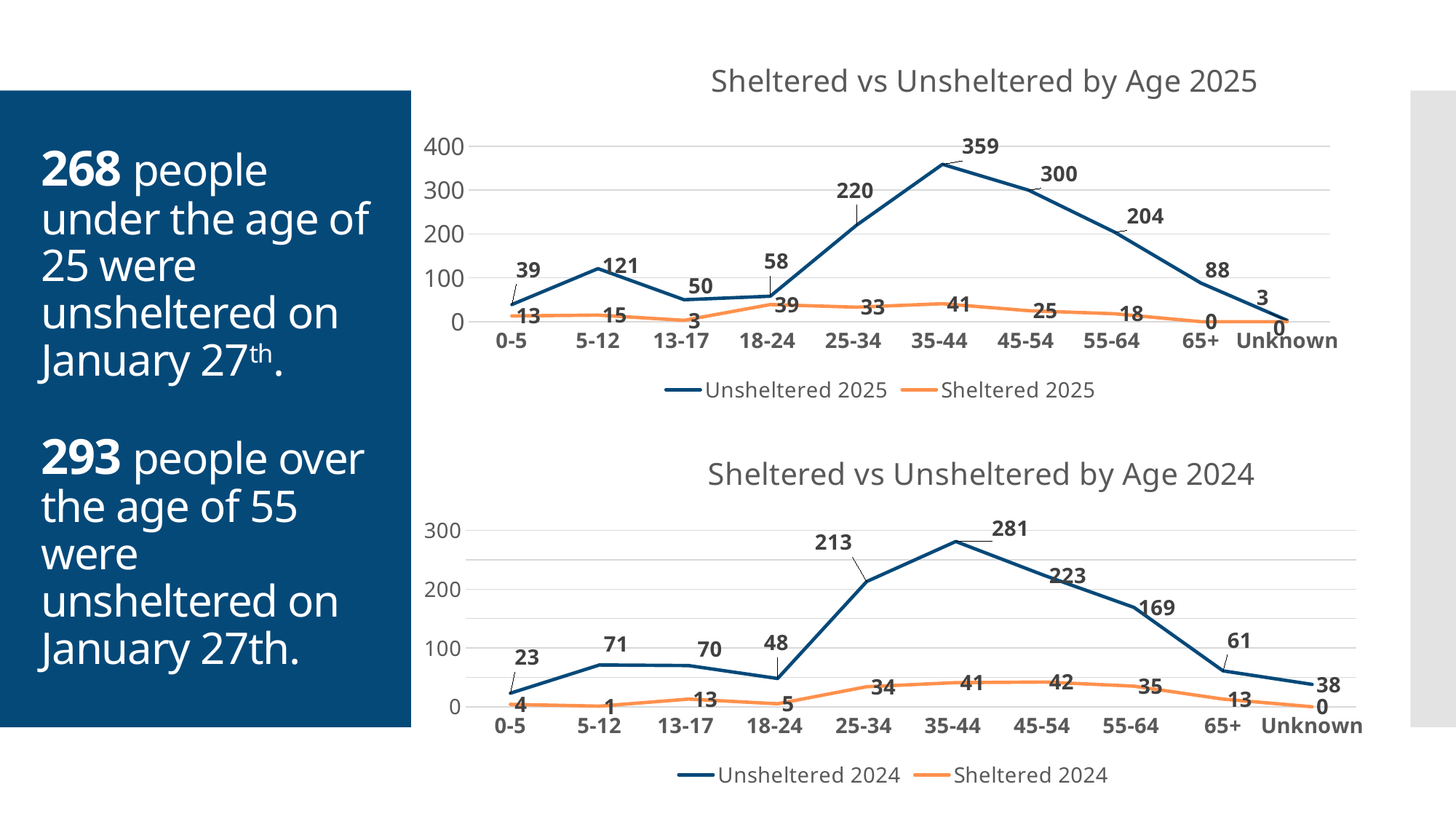
In the 'Sheltered vs Unsheltered by Age 2025' chart, is the Unsheltered 2025 value for 55-64 greater or less than 200? greater In the 'Sheltered vs Unsheltered by Age 2024' chart, which is larger: the Unsheltered 2024 value for 25-34 or for 55-64? 25-34 How many age categories are shown on the x axis of the 'Sheltered vs Unsheltered by Age 2024' chart? 10 In the 'Sheltered vs Unsheltered by Age 2025' chart, does the Unsheltered 2025 line rise or fall from 35-44 to Unknown? Fall In the 'Sheltered vs Unsheltered by Age 2024' chart, what is the Unsheltered 2024 value for the Unknown category? 38 In the 'Sheltered vs Unsheltered by Age 2024' chart, which age group has the highest Unsheltered 2024 value? 35-44 What type of chart is 'Sheltered vs Unsheltered by Age 2024'? Line chart In the 'Sheltered vs Unsheltered by Age 2025' chart, what is the difference between the Unsheltered 2025 and Sheltered 2025 values for the 45-54 age group? 275 In the 'Sheltered vs Unsheltered by Age 2025' chart, what is the Unsheltered 2025 value for the 35-44 age group? 359 In the 'Sheltered vs Unsheltered by Age 2024' chart, which age group has the lowest Sheltered 2024 value? Unknown How many series does the legend of the 'Sheltered vs Unsheltered by Age 2025' chart list? 2 In the 'Sheltered vs Unsheltered by Age 2025' chart, what is the Sheltered 2025 value for the 18-24 age group? 39